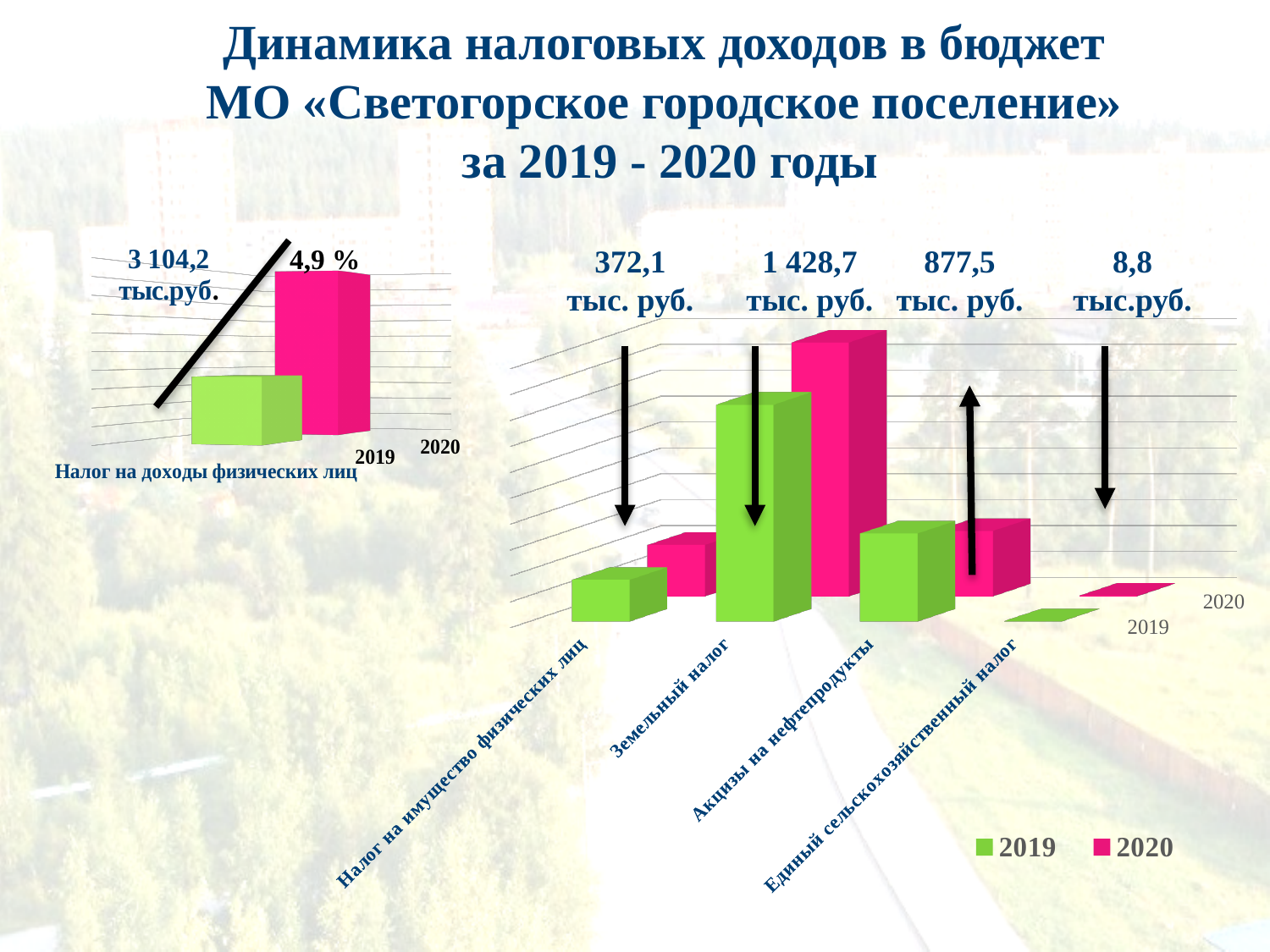
In the right-hand chart, which colour represents the 2020 series? pink In the right-hand chart, how many tax categories are shown on the x axis? 4 In the right-hand chart, which years are listed in the legend? 2019 and 2020 How many charts are on the slide? 2 What kind of chart is the right-hand chart? bar chart In the right-hand chart, for Единый сельскохозяйственный налог, which year has the taller bar, 2019 or 2020? 2020 In the right-hand chart, which category has the tallest bar? Земельный налог In the left-hand chart 'Налог на доходы физических лиц', which year has the taller bar, 2019 or 2020? 2020 What kind of chart is the left-hand chart titled 'Налог на доходы физических лиц'? bar chart In the right-hand chart, which category has the smallest bars? Единый сельскохозяйственный налог In the right-hand chart, how many series does the legend list? 2 In the left-hand chart, what percentage is written next to the arrow? 4,9 %